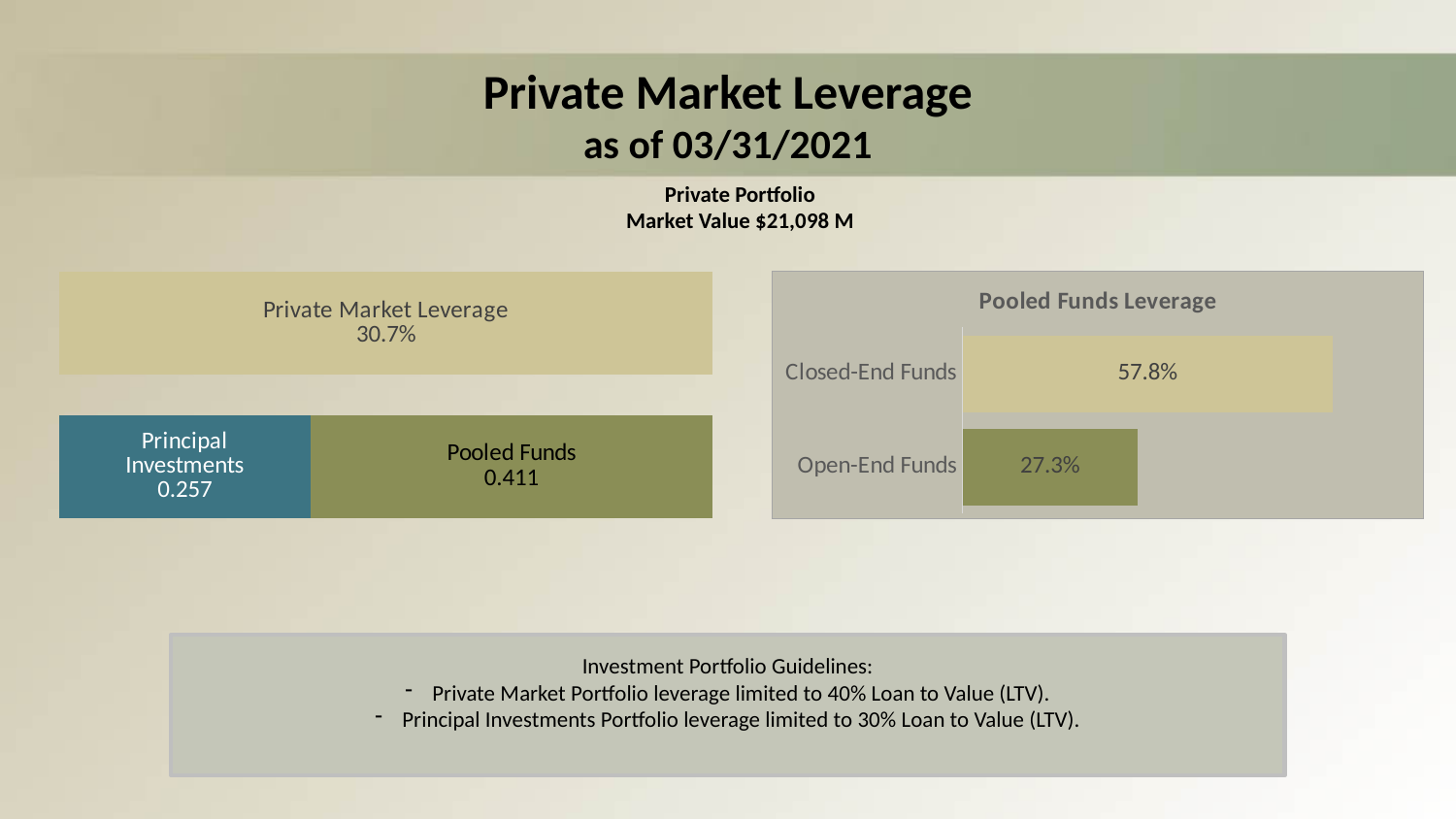
In the Pooled Funds Leverage chart, which category has the lowest value? Open-End Funds In the Pooled Funds Leverage chart, what is the difference between the Closed-End Funds and Open-End Funds values? 30.5% What is the title of the chart on the right? Pooled Funds Leverage In the Pooled Funds Leverage chart, what is the value for Open-End Funds? 27.3% In the chart on the left, what value is shown for Principal Investments? 0.257 In the chart on the left, what value is shown for Private Market Leverage? 30.7% In the Pooled Funds Leverage chart, how many categories are shown? 2 What kind of chart is the Pooled Funds Leverage chart? Bar chart In the Pooled Funds Leverage chart, which category has the highest value? Closed-End Funds In the chart on the left, which is larger, Principal Investments or Pooled Funds? Pooled Funds In the Pooled Funds Leverage chart, what is the value for Closed-End Funds? 57.8% In the chart on the left, what value is shown for Pooled Funds? 0.411